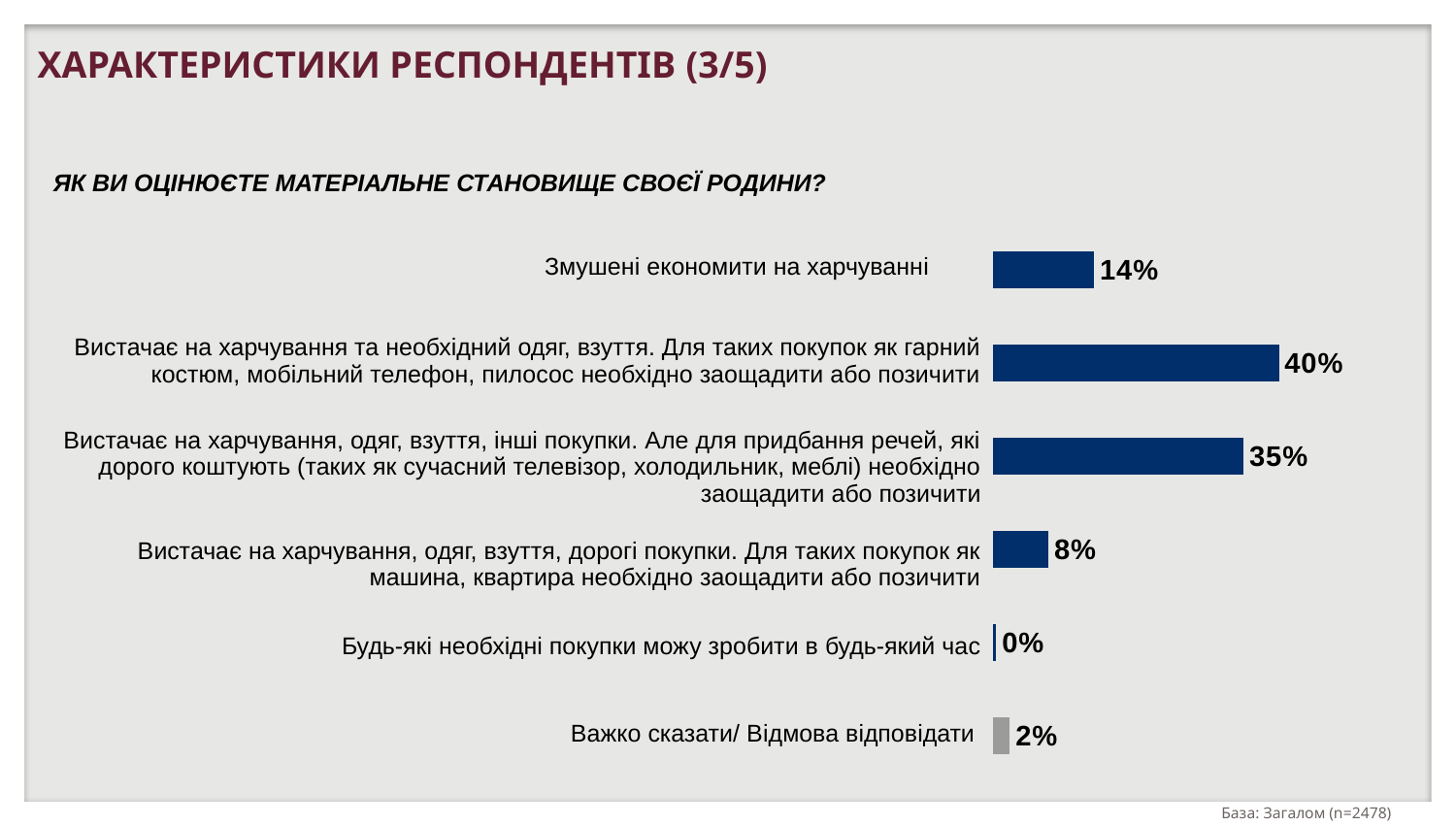
What is the value for "Змушені економити на харчуванні"? 14% Which category has the lowest value? Будь-які необхідні покупки можу зробити в будь-який час What kind of chart is shown on the slide? Bar chart Which category has the highest value? Вистачає на харчування та необхідний одяг, взуття. Для таких покупок як гарний костюм, мобільний телефон, пилосос необхідно заощадити або позичити What is the difference between the value for "Змушені економити на харчуванні" and the value for the category starting "Вистачає на харчування, одяг, взуття, дорогі покупки"? 6% What is the difference between the value for the category starting "Вистачає на харчування та необхідний одяг" (40%) and the category starting "Вистачає на харчування, одяг, взуття, інші покупки" (35%)? 5% Which is larger: the value for "Змушені економити на харчуванні" or the value for "Важко сказати/ Відмова відповідати"? Змушені економити на харчуванні How many categories are shown in the chart? 6 What is the value for "Будь-які необхідні покупки можу зробити в будь-який час"? 0% What question does the chart answer, as stated in the subtitle above it? ЯК ВИ ОЦІНЮЄТЕ МАТЕРІАЛЬНЕ СТАНОВИЩЕ СВОЄЇ РОДИНИ? What is the value for "Важко сказати/ Відмова відповідати"? 2% What is the sample base stated at the bottom of the slide? Загалом (n=2478)